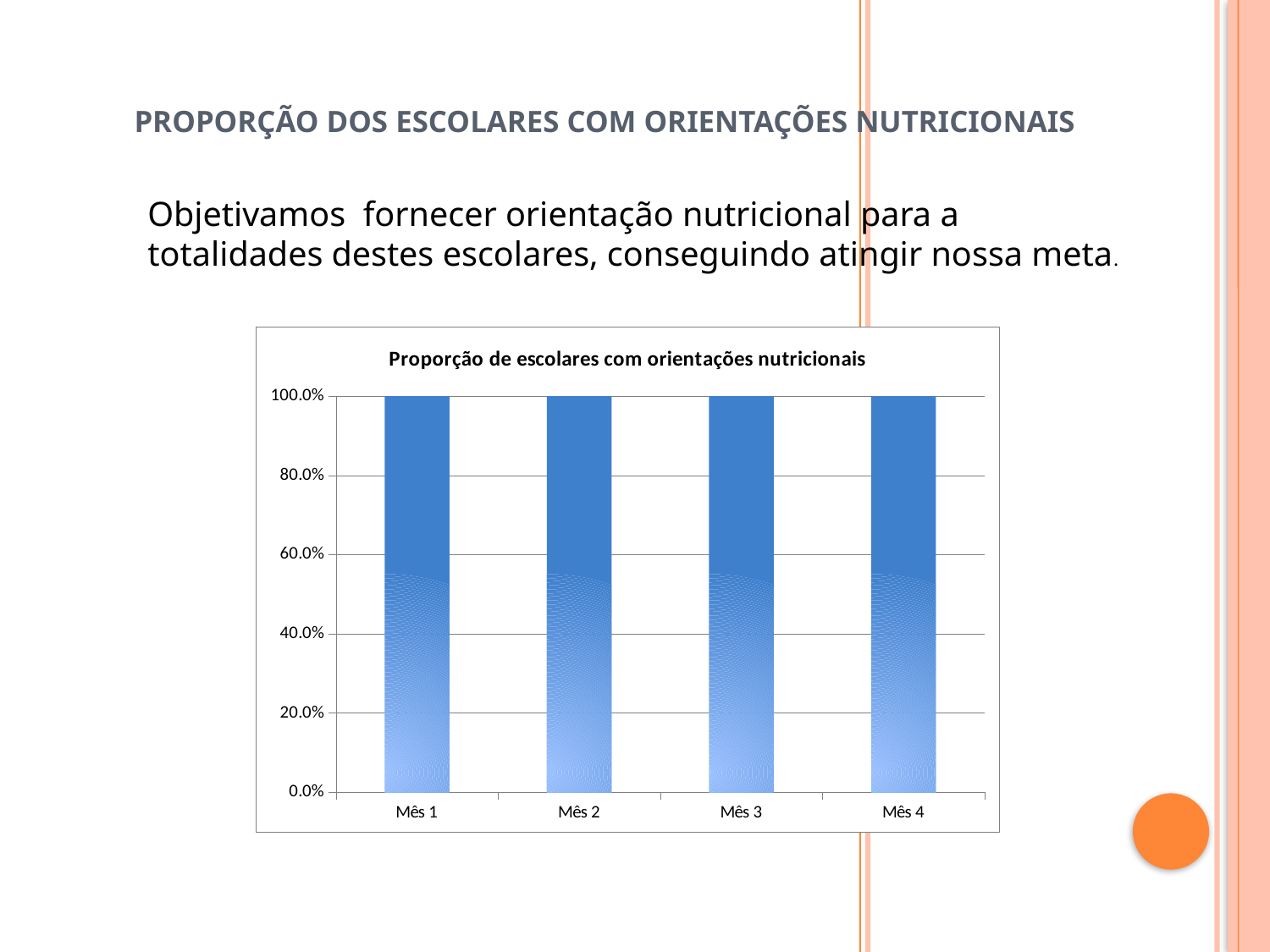
Is the value for Mês 2 greater or less than 80.0%? greater Do the values rise, fall, or stay the same from Mês 1 to Mês 4? stay the same Is the value for Mês 4 greater or less than 60.0%? greater What is the difference between the values for Mês 1 and Mês 2? 0.0% What is the title of the chart? Proporção de escolares com orientações nutricionais What is the value for Mês 3? 100.0% What is the value for Mês 4? 100.0% What is the value for Mês 1? 100.0% What is the label of the first category on the x axis? Mês 1 What is the highest value shown on the y axis? 100.0% What type of chart is shown on the slide? bar chart How many categories are shown on the x axis of the chart? 4